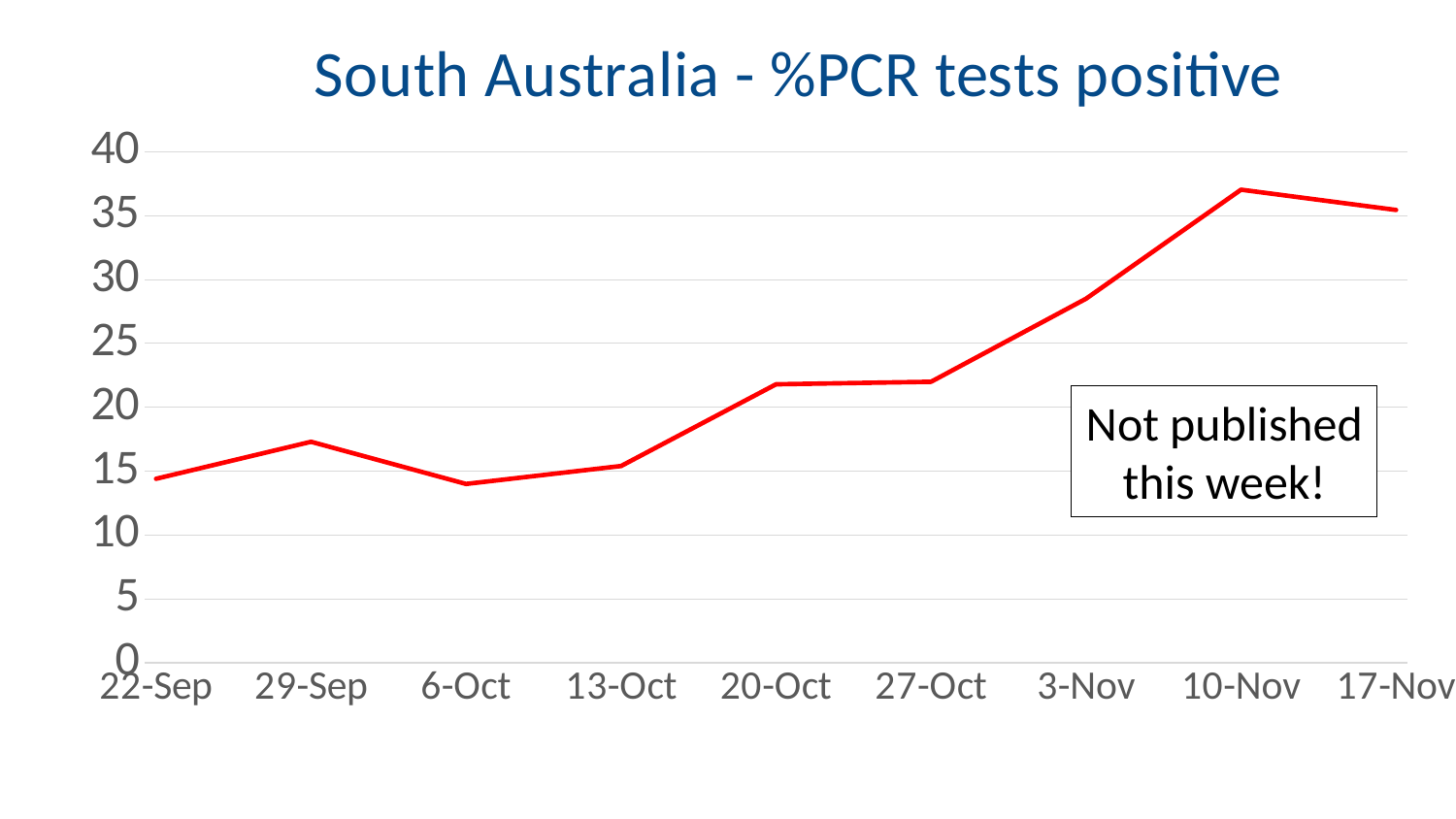
On which date is the % PCR tests positive highest? 10-Nov What is the title of the chart? South Australia - %PCR tests positive What kind of chart is shown on the slide? line chart Which has the larger value, 3-Nov or 27-Oct? 3-Nov Is the value for 3-Nov greater or less than 25? greater What does the text box on the chart say? Not published this week! How many dates are plotted along the x axis? 9 Is the value for 22-Sep greater or less than 20? less Is the value for 10-Nov greater or less than 35? greater Overall, do the values rise or fall from 22-Sep to 17-Nov? rise